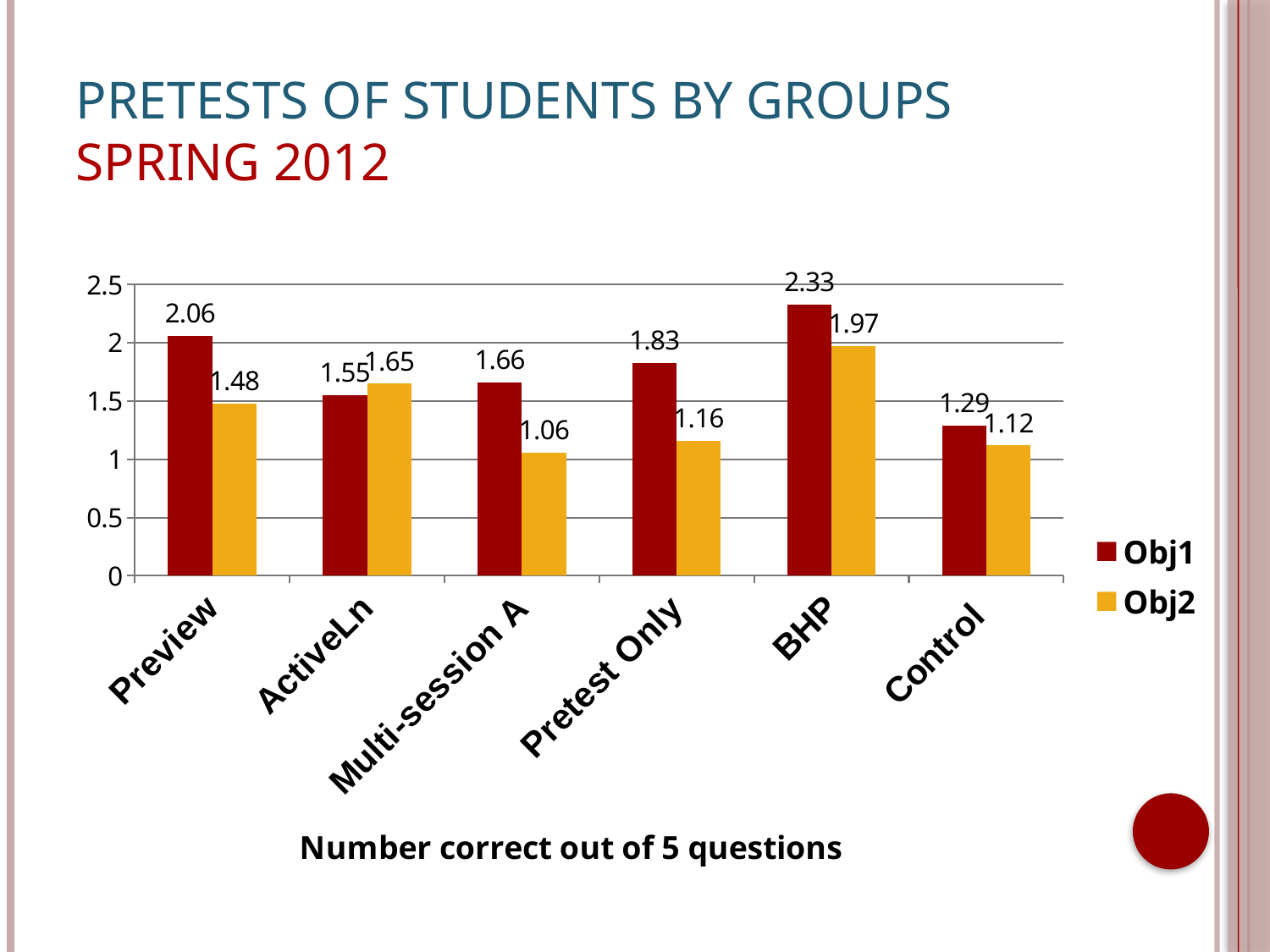
What is the caption below the chart? Number correct out of 5 questions Which group has the highest Obj2 value? BHP Which is larger for ActiveLn, the Obj1 value or the Obj2 value? Obj2 How many series does the legend list? 2 How many groups are shown on the x axis? 6 What is the difference between the Obj1 and Obj2 values for Preview? 0.58 What is the Obj2 value for Multi-session A? 1.06 What is the Obj1 value for BHP? 2.33 Which group has the lowest Obj1 value? Control What kind of chart is shown on the slide? bar chart Is the Obj2 value for Control greater or less than 1.5? less What is the Obj1 value for Pretest Only? 1.83